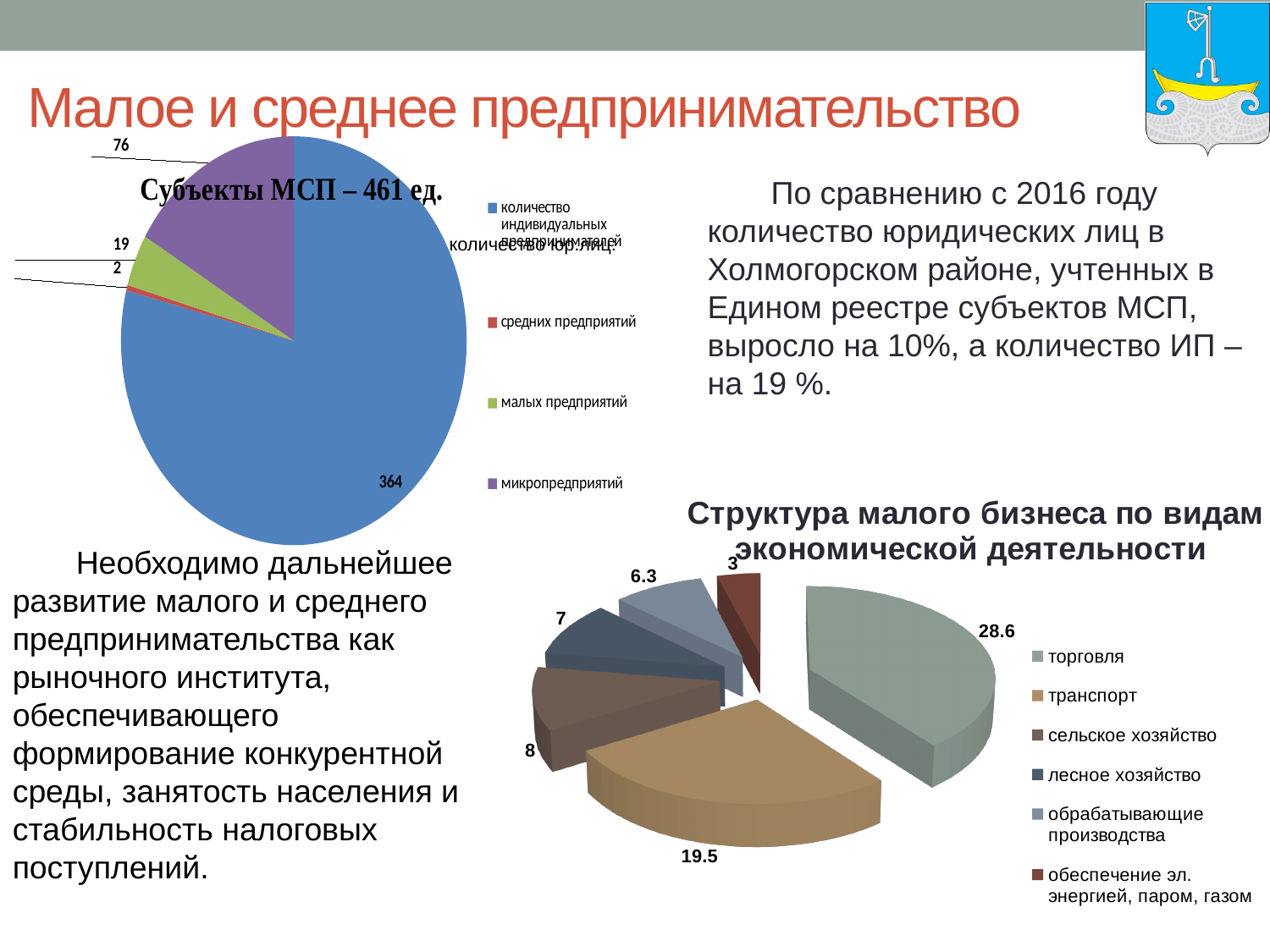
In the chart titled "Структура малого бизнеса по видам экономической деятельности", which is larger: сельское хозяйство or лесное хозяйство? сельское хозяйство In the chart titled "Структура малого бизнеса по видам экономической деятельности", what is the value for обрабатывающие производства? 6.3 In the chart titled "Субъекты МСП – 461 ед.", what is the value for средних предприятий? 2 In the chart titled "Субъекты МСП – 461 ед.", what is the difference between the value for individual entrepreneurs (364) and микропредприятий (76)? 288 What kind of chart is the one titled "Структура малого бизнеса по видам экономической деятельности"? pie chart In the chart titled "Субъекты МСП – 461 ед.", what is the value for микропредприятий? 76 In the chart titled "Субъекты МСП – 461 ед.", which category has the smallest slice? средних предприятий In the chart titled "Структура малого бизнеса по видам экономической деятельности", which category has the largest value? торговля In the chart titled "Субъекты МСП – 461 ед.", which category has the largest slice? количество индивидуальных предпринимателей How many entries does the legend of the chart titled "Структура малого бизнеса по видам экономической деятельности" list? 6 In the chart titled "Структура малого бизнеса по видам экономической деятельности", what is the value for транспорт? 19.5 In the chart titled "Субъекты МСП – 461 ед.", how many slices does the pie have? 4